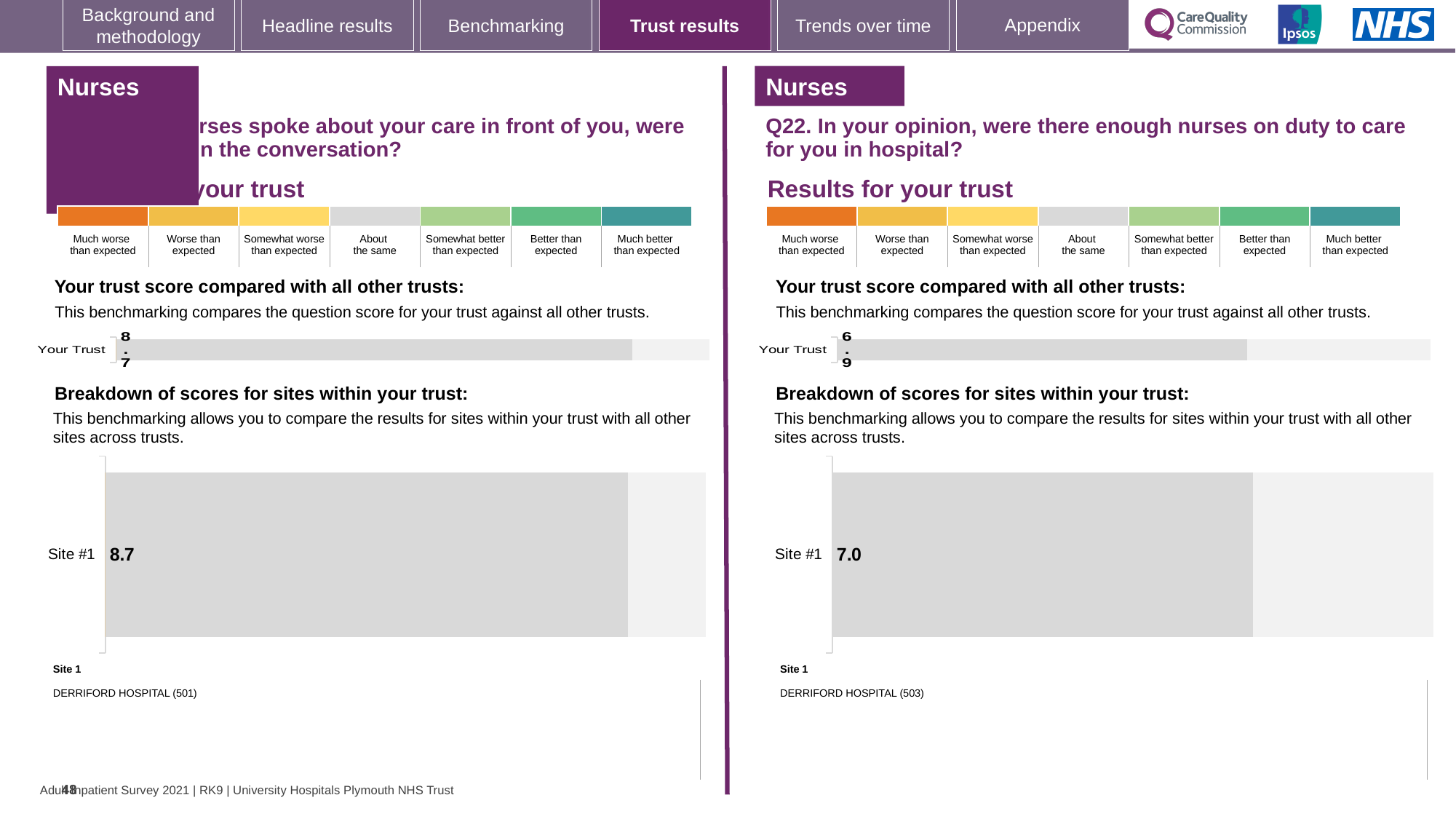
Which hospital is listed as Site 1 beneath the site breakdown chart on the right-hand panel (Q22)? DERRIFORD HOSPITAL (503) Which is larger: the Site #1 score on the left-hand panel or the Site #1 score on the right-hand panel (Q22)? Left-hand panel (8.7) How many sites are shown in the 'Breakdown of scores for sites within your trust' chart on the right-hand panel (Q22)? 1 What is the difference between the Your Trust score on the left-hand panel and the Your Trust score on the right-hand panel (Q22)? 1.8 On the left-hand panel, what score is shown for Site #1 in the 'Breakdown of scores for sites within your trust' chart? 8.7 On the left-hand panel, what is the score shown for Your Trust in the 'Your trust score compared with all other trusts' chart? 8.7 What type of chart is used to show the Site #1 score on the right-hand panel (Q22)? Bar chart On the right-hand panel (Q22), what is the score shown for Your Trust in the 'Your trust score compared with all other trusts' chart? 6.9 On the right-hand panel (Q22), what score is shown for Site #1 in the 'Breakdown of scores for sites within your trust' chart? 7.0 Which hospital is listed as Site 1 beneath the site breakdown chart on the left-hand panel? DERRIFORD HOSPITAL (501) On the right-hand panel (Q22), which is larger: the Your Trust score or the Site #1 score? Site #1 (7.0) What is the difference between the Site #1 score on the left-hand panel and the Site #1 score on the right-hand panel (Q22)? 1.7